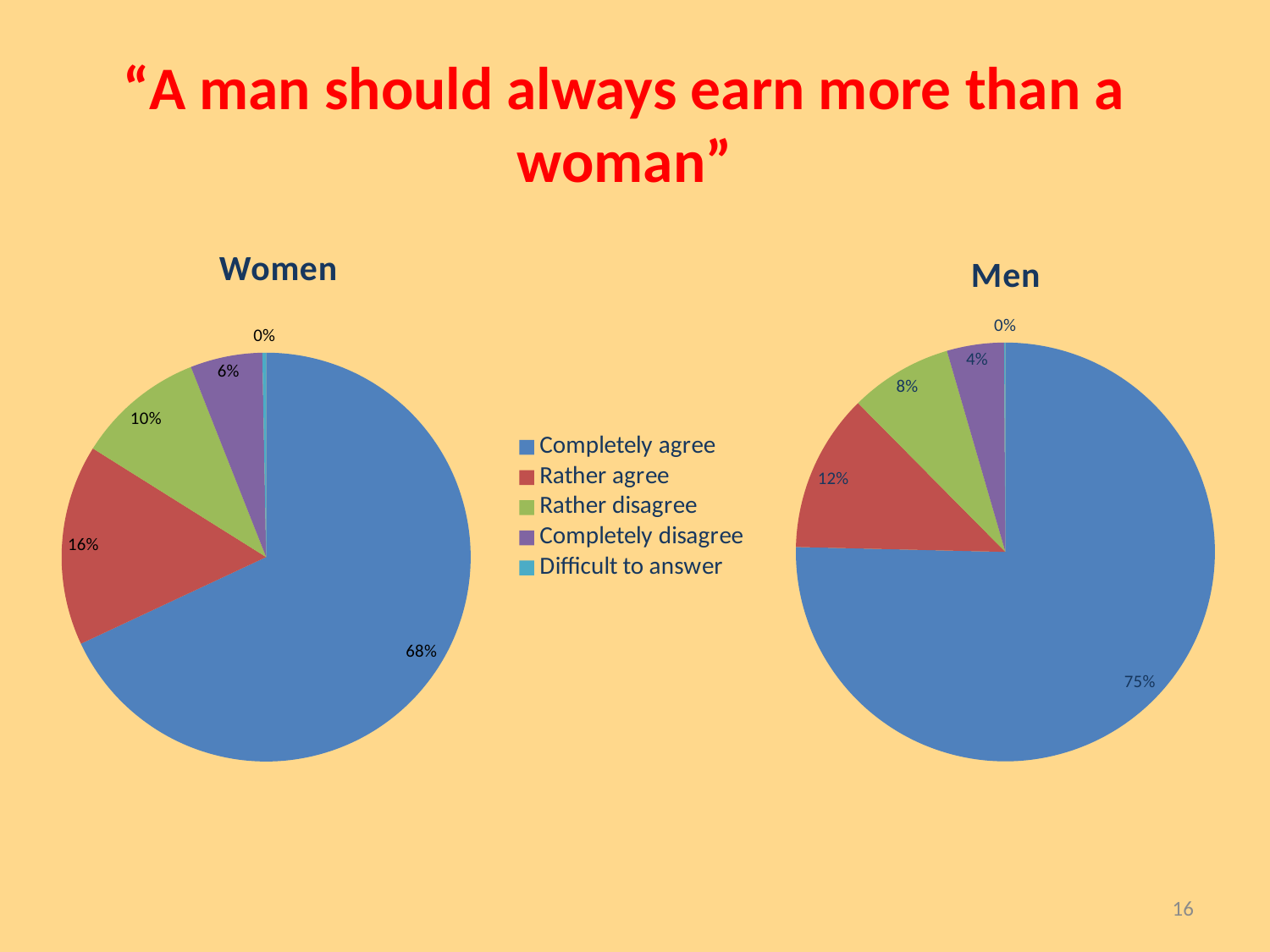
In the Men chart, what percentage of respondents completely disagree? 4% In the Women chart, what percentage of respondents completely agree? 68% In the Men chart, what percentage of respondents rather disagree? 8% In the Women chart, what percentage of respondents rather agree? 16% What colour represents 'Rather disagree' in the charts? Green In the Women chart, which response has the largest share? Completely agree In the Men chart, which response has the smallest share? Difficult to answer Is the 'Rather agree' share larger in the Women chart or the Men chart? Women What is the difference between the 'Completely agree' share in the Men chart and in the Women chart? 7% How many categories does the legend list? 5 In the Men chart, what percentage of respondents completely agree? 75% What type of chart is the Women chart? Pie chart